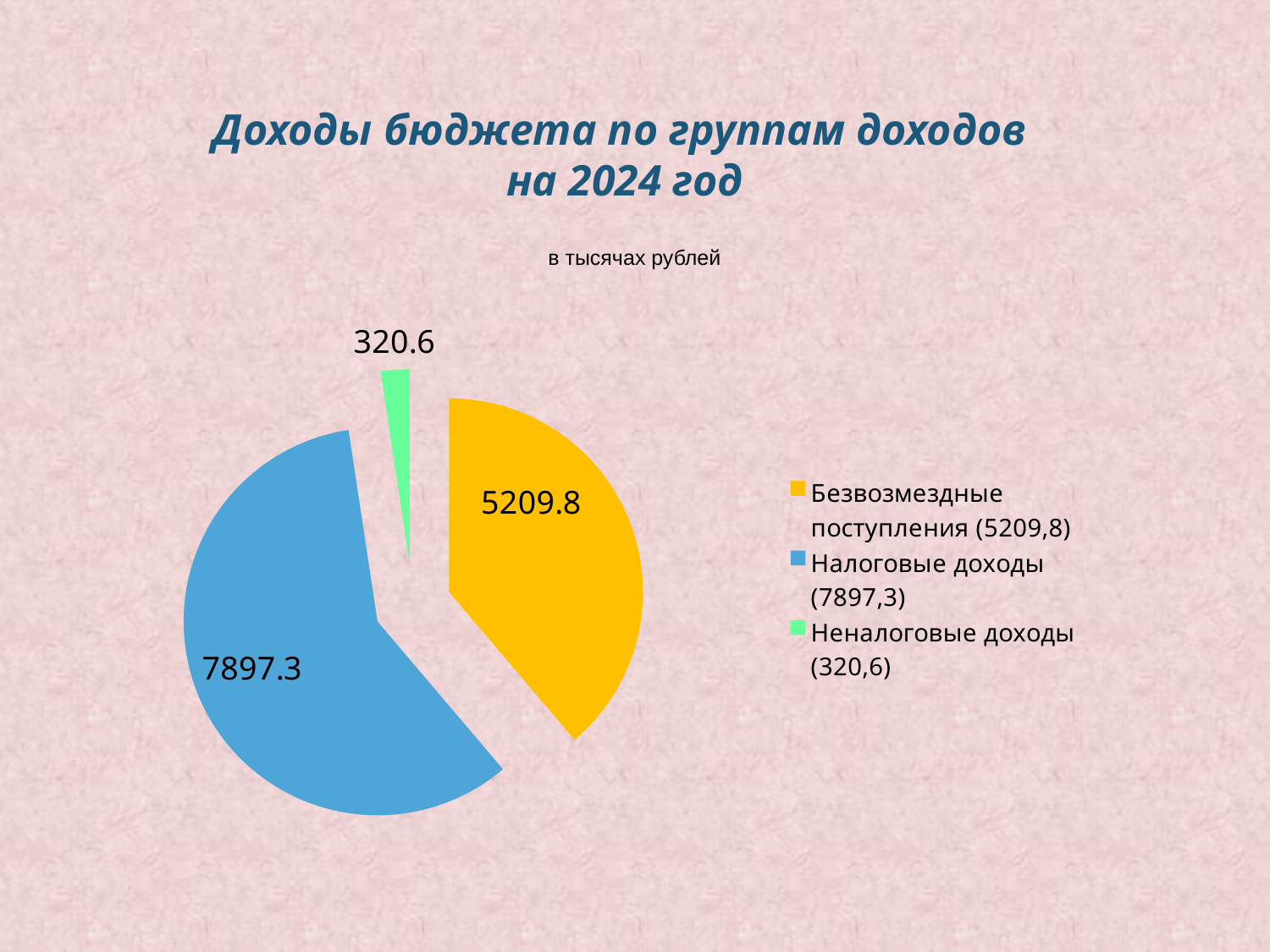
How many slices does the pie chart have? 3 What is the value for Неналоговые доходы? 320.6 What type of chart is shown on the slide? Pie chart What is the value for Налоговые доходы? 7897.3 Which is larger, Безвозмездные поступления or Неналоговые доходы? Безвозмездные поступления What is the value for Безвозмездные поступления? 5209.8 In what units are the values on the chart given? в тысячах рублей What is the total of all three income groups? 13427.7 Which income group has the smallest value? Неналоговые доходы What is the difference between Безвозмездные поступления and Неналоговые доходы? 4889.2 What is the difference between Налоговые доходы and Безвозмездные поступления? 2687.5 Which income group has the largest value? Налоговые доходы